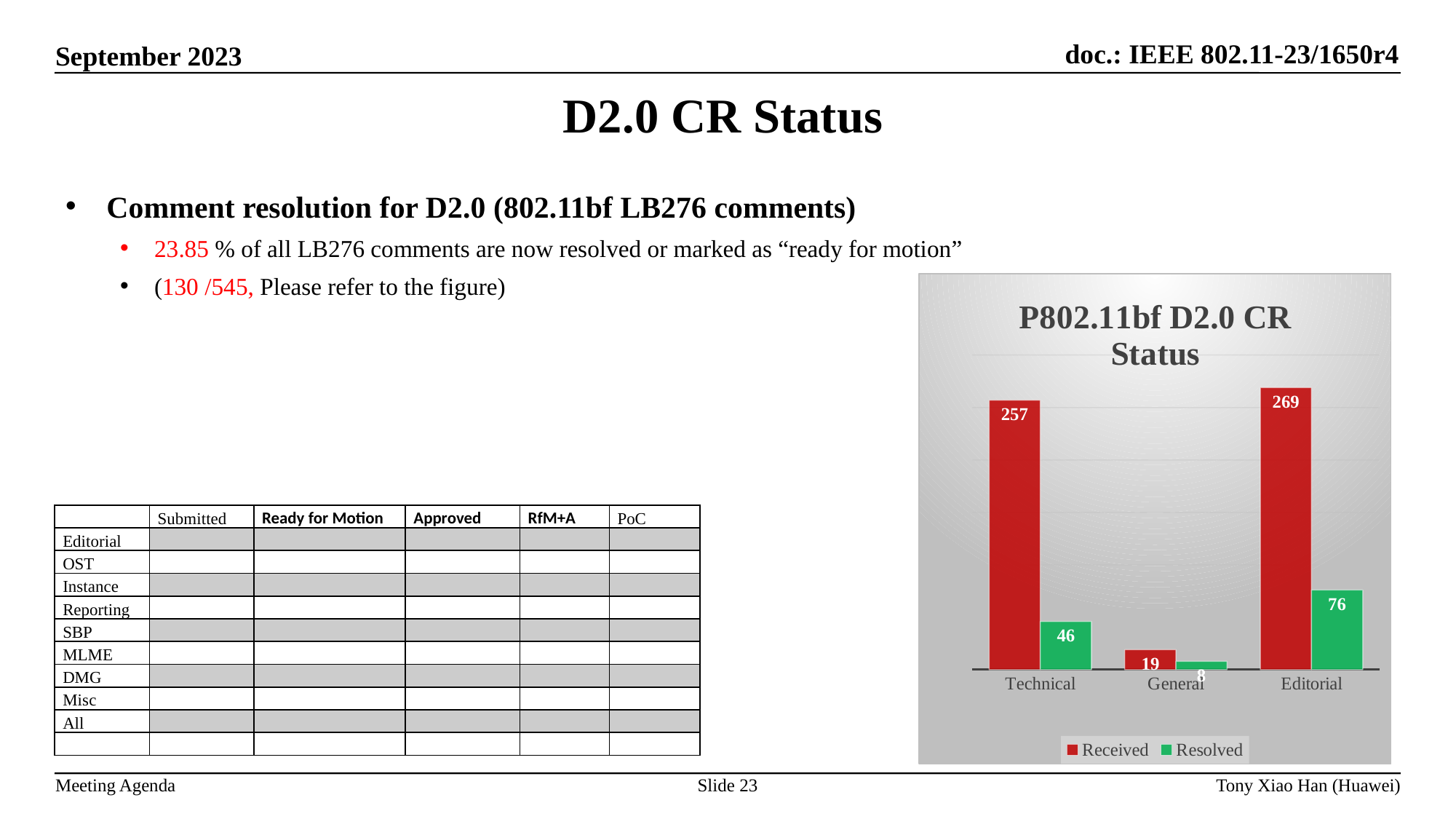
What is the Received value for Technical? 257 Which is larger, the Resolved value for Editorial or the Resolved value for Technical? Editorial How many series does the chart legend list? 2 What is the Resolved value for Technical? 46 What is the difference between the Received and Resolved values for Technical? 211 How many categories are shown on the x axis of the chart? 3 What is the title of the chart? P802.11bf D2.0 CR Status What is the Received value for General? 19 What is the Resolved value for Editorial? 76 What type of chart is shown on the slide? bar chart Which category has the lowest Resolved value? General Which category has the highest Received value? Editorial